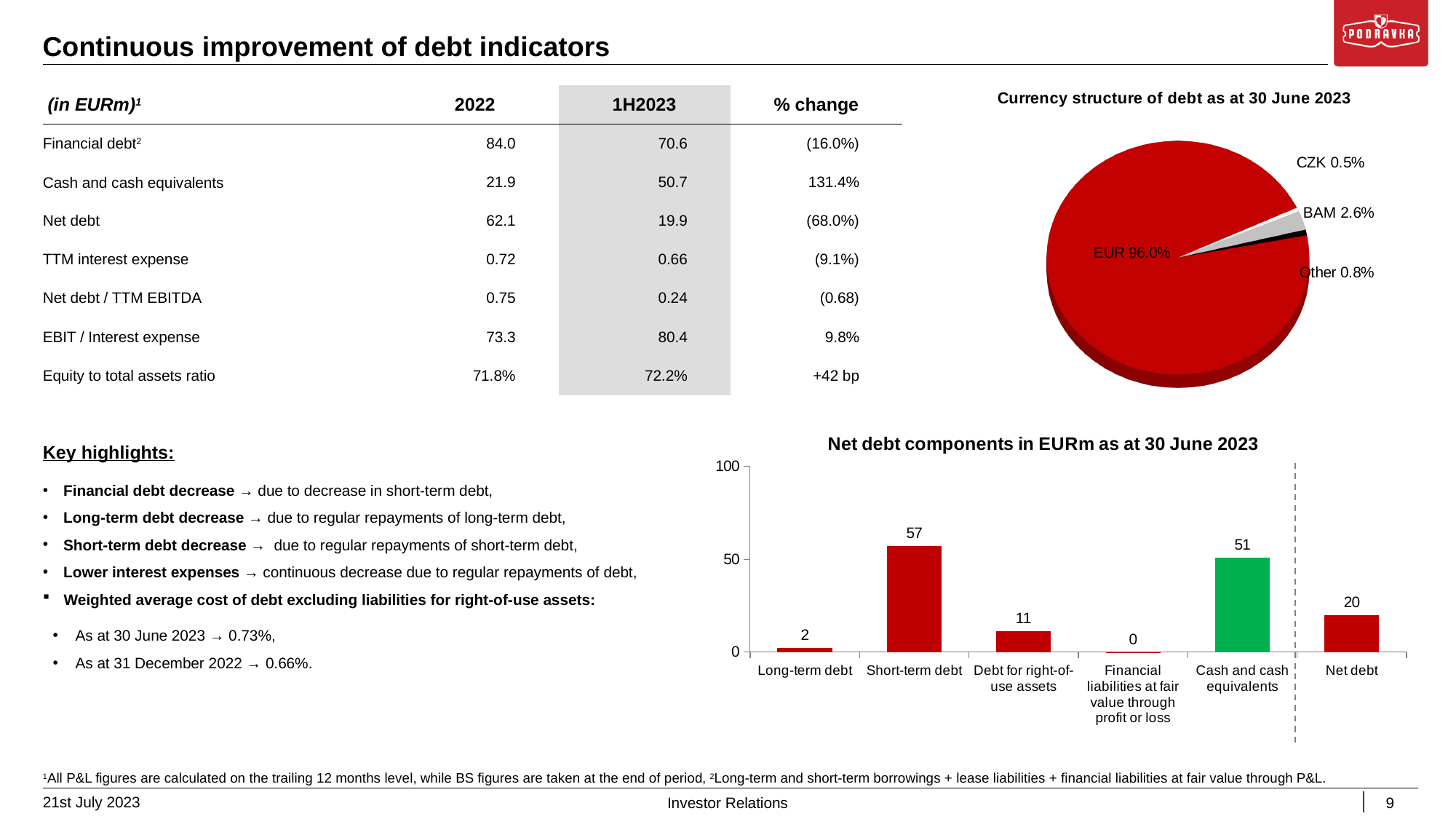
In the 'Net debt components in EURm as at 30 June 2023' chart, which category has the lowest value? Financial liabilities at fair value through profit or loss How many categories are shown in the 'Net debt components in EURm as at 30 June 2023' chart? 6 In the 'Net debt components in EURm as at 30 June 2023' chart, what is the value for Debt for right-of-use assets? 11 What kind of chart is 'Net debt components in EURm as at 30 June 2023'? Bar chart In the 'Currency structure of debt as at 30 June 2023' chart, what share of debt is in EUR? 96.0% In the 'Net debt components in EURm as at 30 June 2023' chart, what is the difference between Short-term debt and Cash and cash equivalents? 6 In the 'Net debt components in EURm as at 30 June 2023' chart, what is the value for Short-term debt? 57 In the 'Currency structure of debt as at 30 June 2023' chart, what share of debt is in BAM? 2.6% In the 'Net debt components in EURm as at 30 June 2023' chart, what is the value for Cash and cash equivalents? 51 In the 'Net debt components in EURm as at 30 June 2023' chart, which category has the highest value? Short-term debt What kind of chart is 'Currency structure of debt as at 30 June 2023'? Pie chart In the 'Net debt components in EURm as at 30 June 2023' chart, which is larger: Long-term debt or Net debt? Net debt